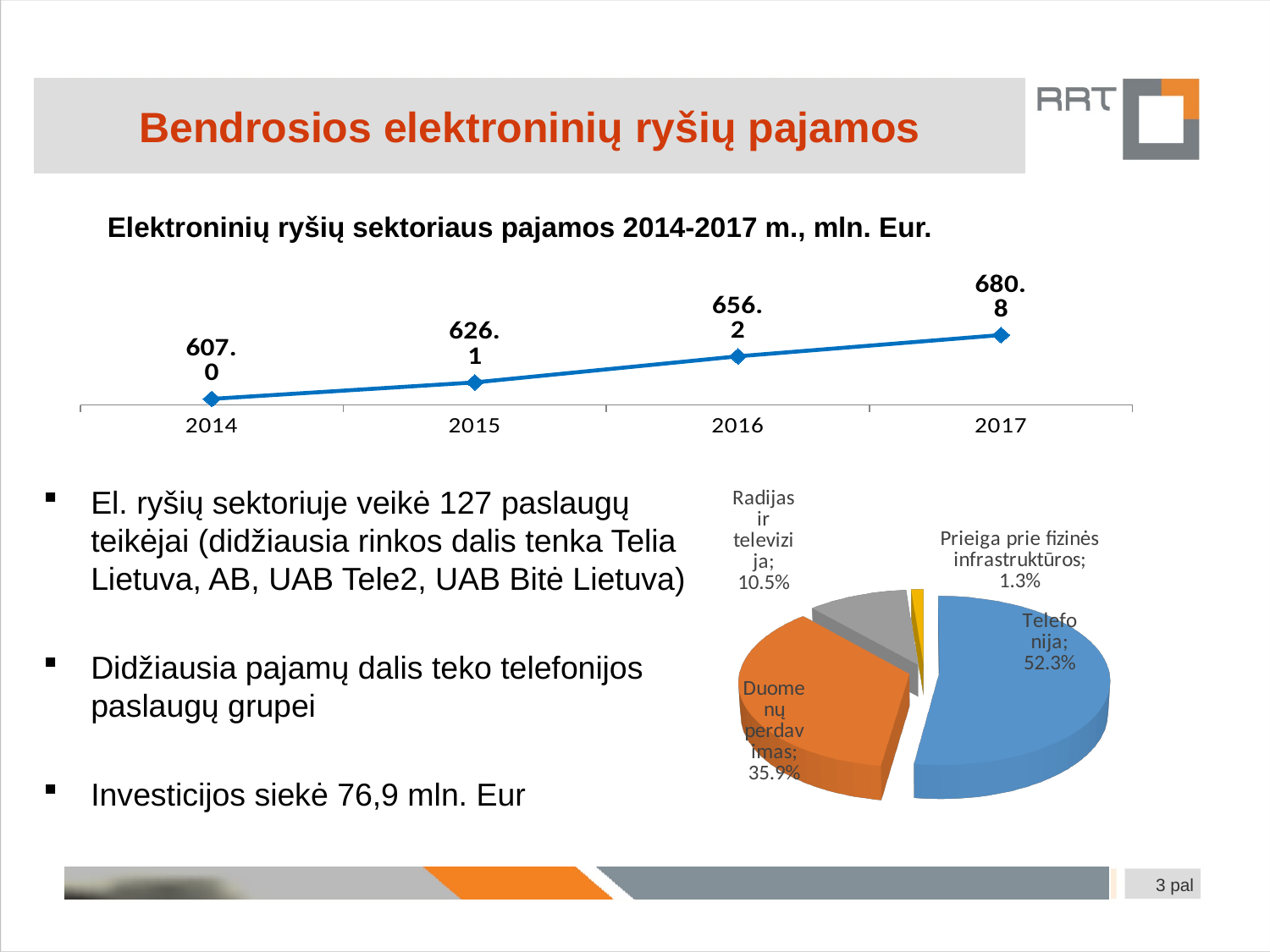
On the line chart 'Elektroninių ryšių sektoriaus pajamos 2014-2017 m., mln. Eur.', what is the difference between the 2017 and 2014 values? 73.8 On the pie chart at the bottom right, which category has the largest slice? Telefonija On the line chart 'Elektroninių ryšių sektoriaus pajamos 2014-2017 m., mln. Eur.', what is the value for 2017? 680.8 On the line chart 'Elektroninių ryšių sektoriaus pajamos 2014-2017 m., mln. Eur.', which year has the highest value? 2017 On the line chart 'Elektroninių ryšių sektoriaus pajamos 2014-2017 m., mln. Eur.', how many years are plotted? 4 On the pie chart at the bottom right, what share does 'Telefonija' have? 52.3% On the pie chart at the bottom right, what share does 'Prieiga prie fizinės infrastruktūros' have? 1.3% On the pie chart at the bottom right, which is larger: 'Duomenų perdavimas' or 'Radijas ir televizija'? Duomenų perdavimas What kind of chart is the upper chart 'Elektroninių ryšių sektoriaus pajamos 2014-2017 m., mln. Eur.'? line chart On the line chart 'Elektroninių ryšių sektoriaus pajamos 2014-2017 m., mln. Eur.', do the values rise or fall from 2014 to 2017? rise On the line chart 'Elektroninių ryšių sektoriaus pajamos 2014-2017 m., mln. Eur.', which year has the lowest value? 2014 On the line chart 'Elektroninių ryšių sektoriaus pajamos 2014-2017 m., mln. Eur.', what is the value for 2014? 607.0